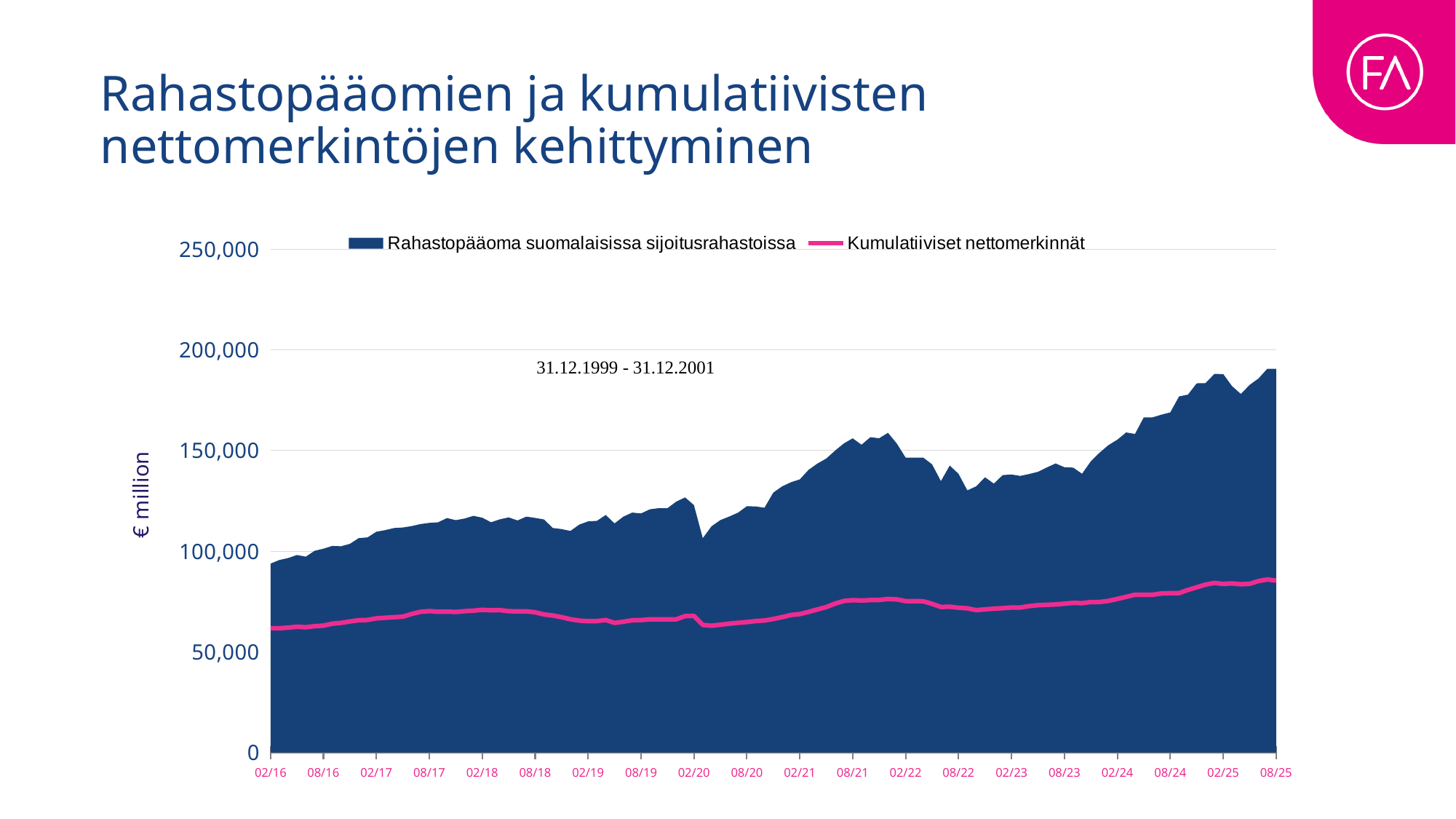
What are the two series named in the legend? Rahastopääoma suomalaisissa sijoitusrahastoissa; Kumulatiiviset nettomerkinnät At which x-axis label is the Rahastopääoma suomalaisissa sijoitusrahastoissa series at its lowest? 02/16 How many date labels are shown on the x-axis? 20 What kind of chart is shown on the slide? Area chart with a line series Is the value of Rahastopääoma suomalaisissa sijoitusrahastoissa at 08/25 greater or less than 150,000? greater Does the Rahastopääoma suomalaisissa sijoitusrahastoissa series generally rise or fall from 02/16 to 08/25? rise What unit is shown on the y-axis label? € million Is the value of Rahastopääoma suomalaisissa sijoitusrahastoissa at 02/16 greater or less than 100,000? less How many series does the legend list? 2 Is the value of Kumulatiiviset nettomerkinnät at 08/25 greater or less than 100,000? less At 08/25, which series has the larger value: Rahastopääoma suomalaisissa sijoitusrahastoissa or Kumulatiiviset nettomerkinnät? Rahastopääoma suomalaisissa sijoitusrahastoissa